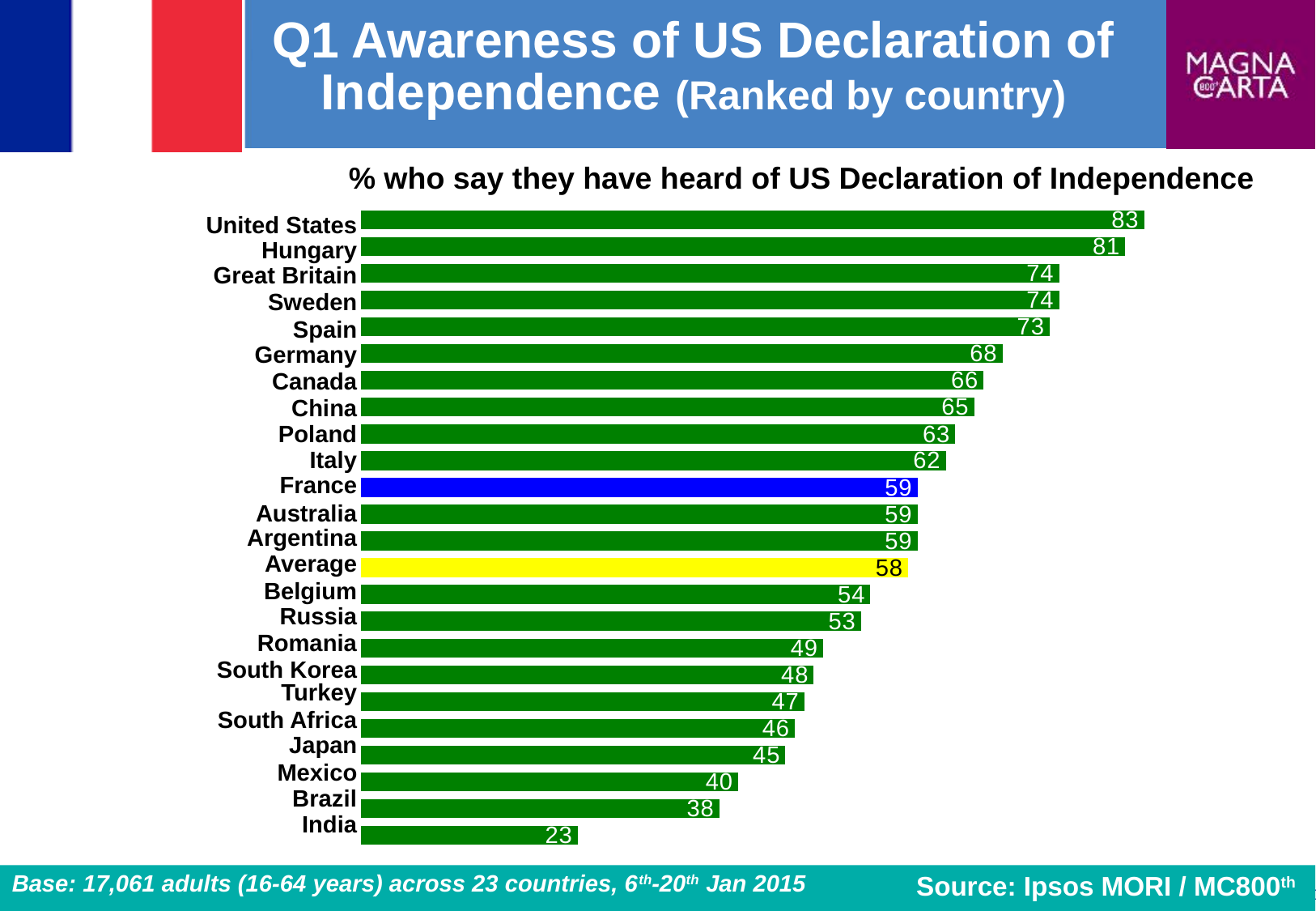
What colour is the bar for the Average? Yellow What percentage of people in Hungary say they have heard of the US Declaration of Independence? 81 What is the value shown for France? 59 What is the difference between the values for the United States and India? 60 Which country has the highest awareness of the US Declaration of Independence? United States What is the value shown for Japan? 45 What is the value shown for the Average bar? 58 What is the difference between the values for Germany and Belgium? 14 Which has a higher value, Canada or Poland? Canada Which country has the lowest awareness of the US Declaration of Independence? India How many bars are plotted on the chart, including the Average bar? 24 What type of chart is shown on the slide? Bar chart